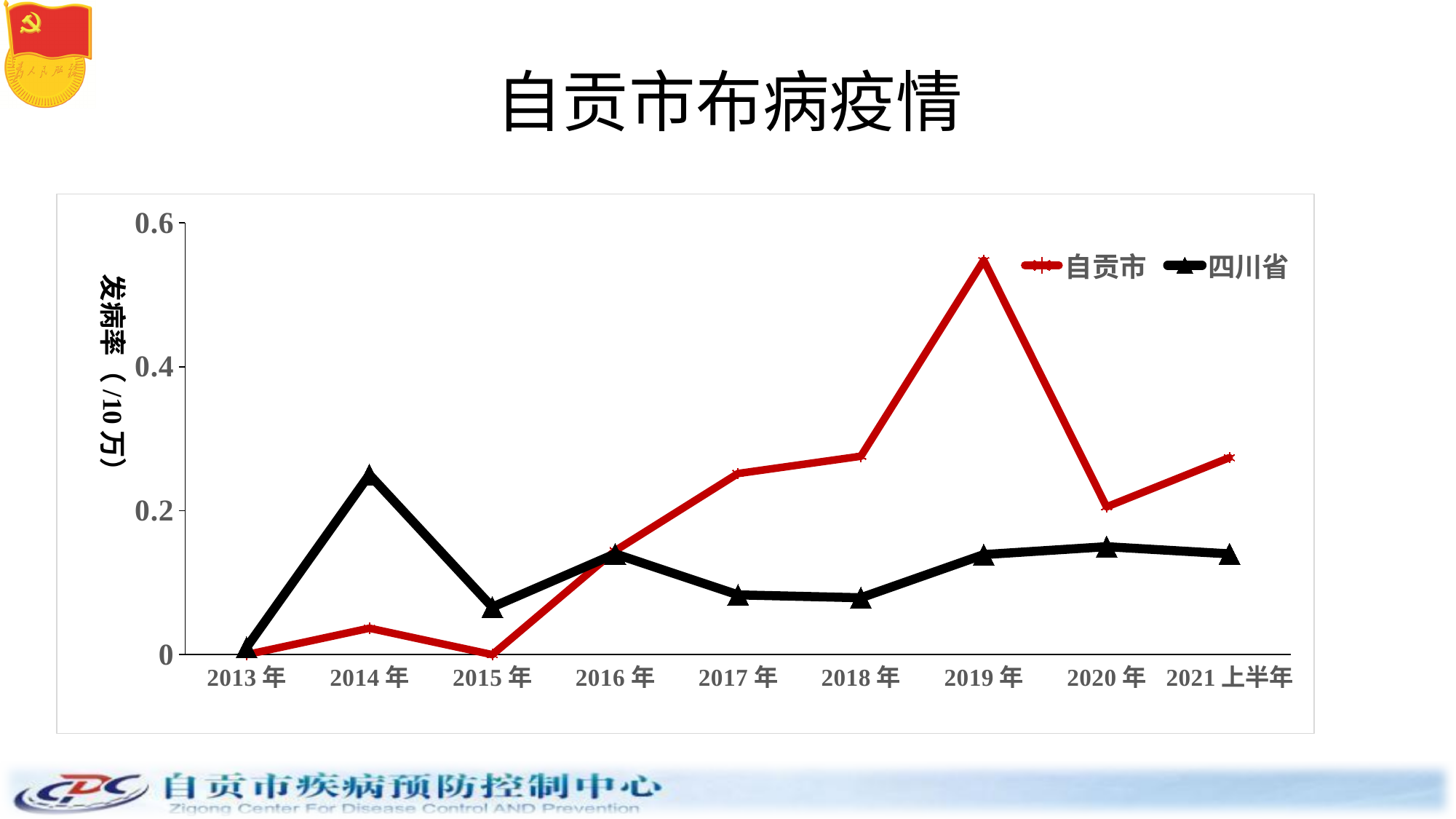
Is the value for 自贡市 in 2019 年 greater or less than 0.4? greater In 2014 年, which series has the higher value, 自贡市 or 四川省? 四川省 In which year does the 自贡市 series reach its highest value? 2019 年 How many series does the legend list? 2 Is the value for 四川省 in 2017 年 greater or less than 0.2? less Does the 自贡市 series rise or fall from 2016 年 to 2019 年? rise What kind of chart is shown on the slide? line chart Is the value for 自贡市 in 2017 年 greater or less than 0.2? greater In which year does the 四川省 series reach its highest value? 2014 年 How many time points are plotted along the x axis? 9 In 2019 年, which series has the higher value, 自贡市 or 四川省? 自贡市